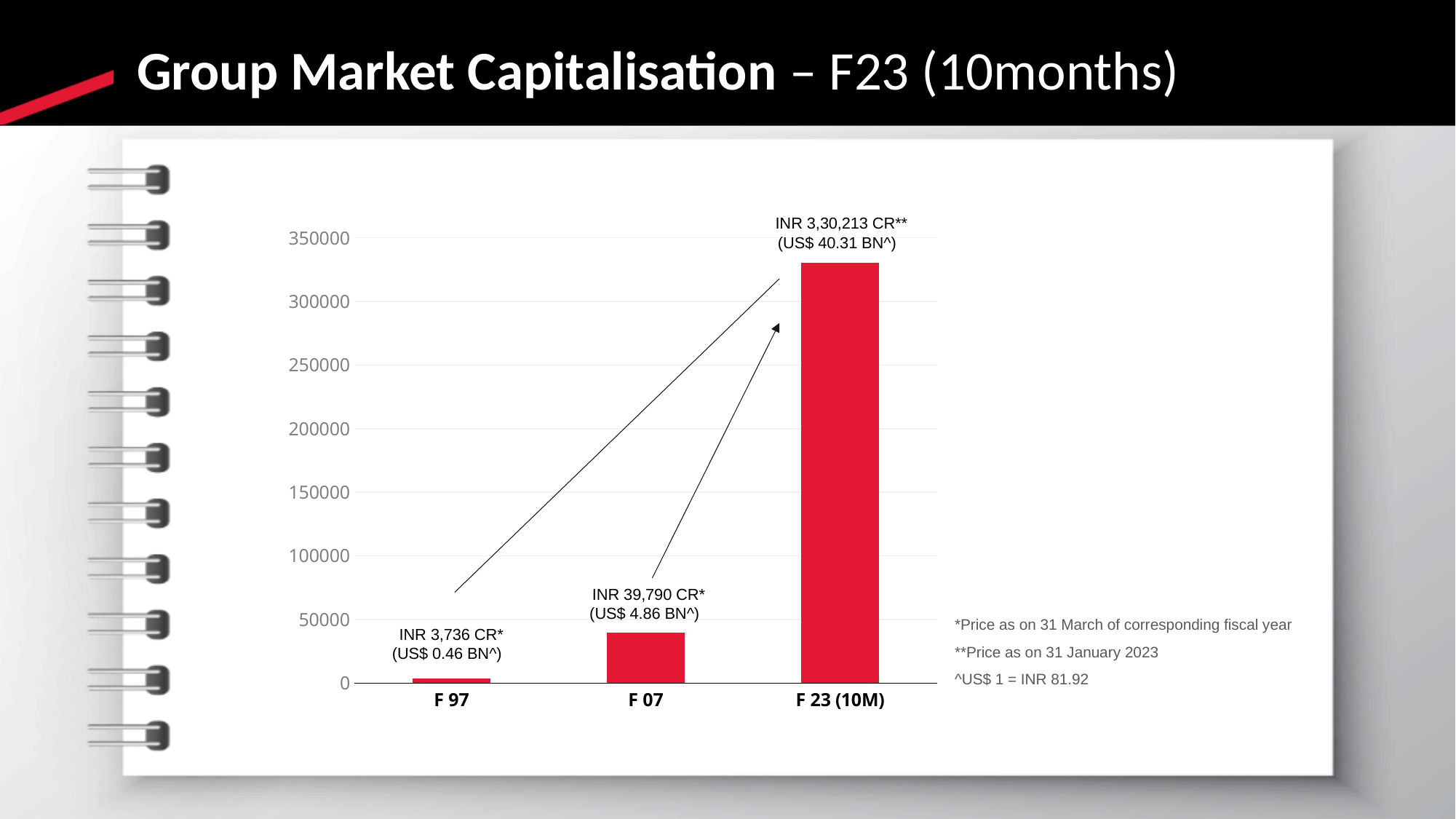
Which is larger, the market capitalisation for F 07 or for F 97? F 07 Do the values rise or fall from F 97 to F 23 (10M)? Rise What is the US$ value shown for F 07? US$ 4.86 BN Which period has the lowest market capitalisation? F 97 What is the US$ value shown for F 23 (10M)? US$ 40.31 BN What is the market capitalisation in INR for F 97? INR 3,736 CR What is the market capitalisation in INR for F 07? INR 39,790 CR Is the value for F 23 (10M) greater or less than 300000? greater What is the market capitalisation in INR for F 23 (10M)? INR 3,30,213 CR How many periods are shown on the x axis? 3 What kind of chart is shown on the slide? Bar chart Which period has the highest market capitalisation? F 23 (10M)